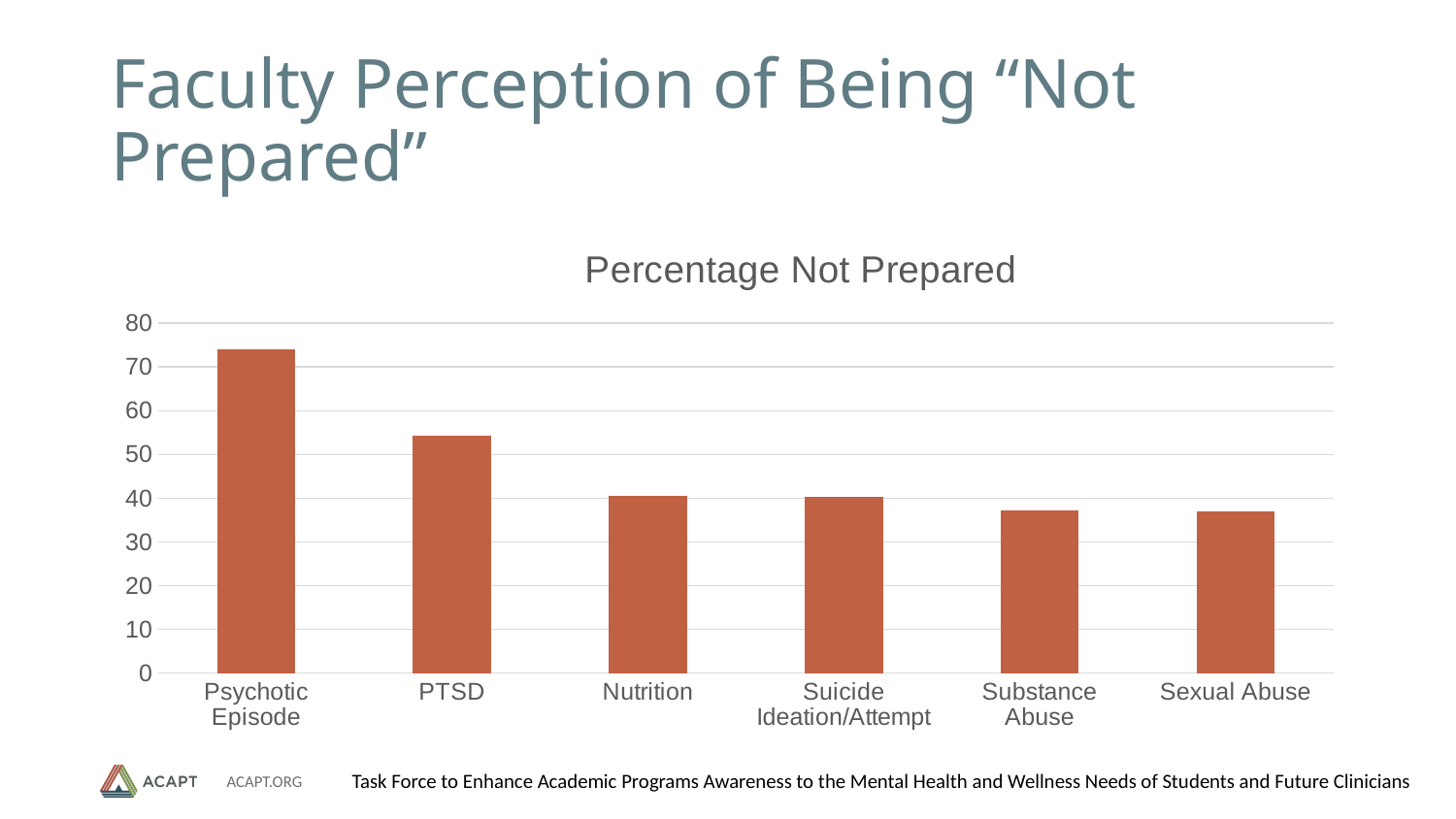
Is the value for Psychotic Episode greater or less than 80? less How many categories are shown on the x axis of the chart? 6 Which category has the highest percentage not prepared? Psychotic Episode Is the value for PTSD greater or less than 50? greater What is the title of the chart? Percentage Not Prepared Do the values generally rise or fall moving from left to right along the x axis? fall What type of chart is shown on the slide? bar chart Is the value for Substance Abuse greater or less than 40? less Which is larger, the value for Psychotic Episode or the value for PTSD? Psychotic Episode